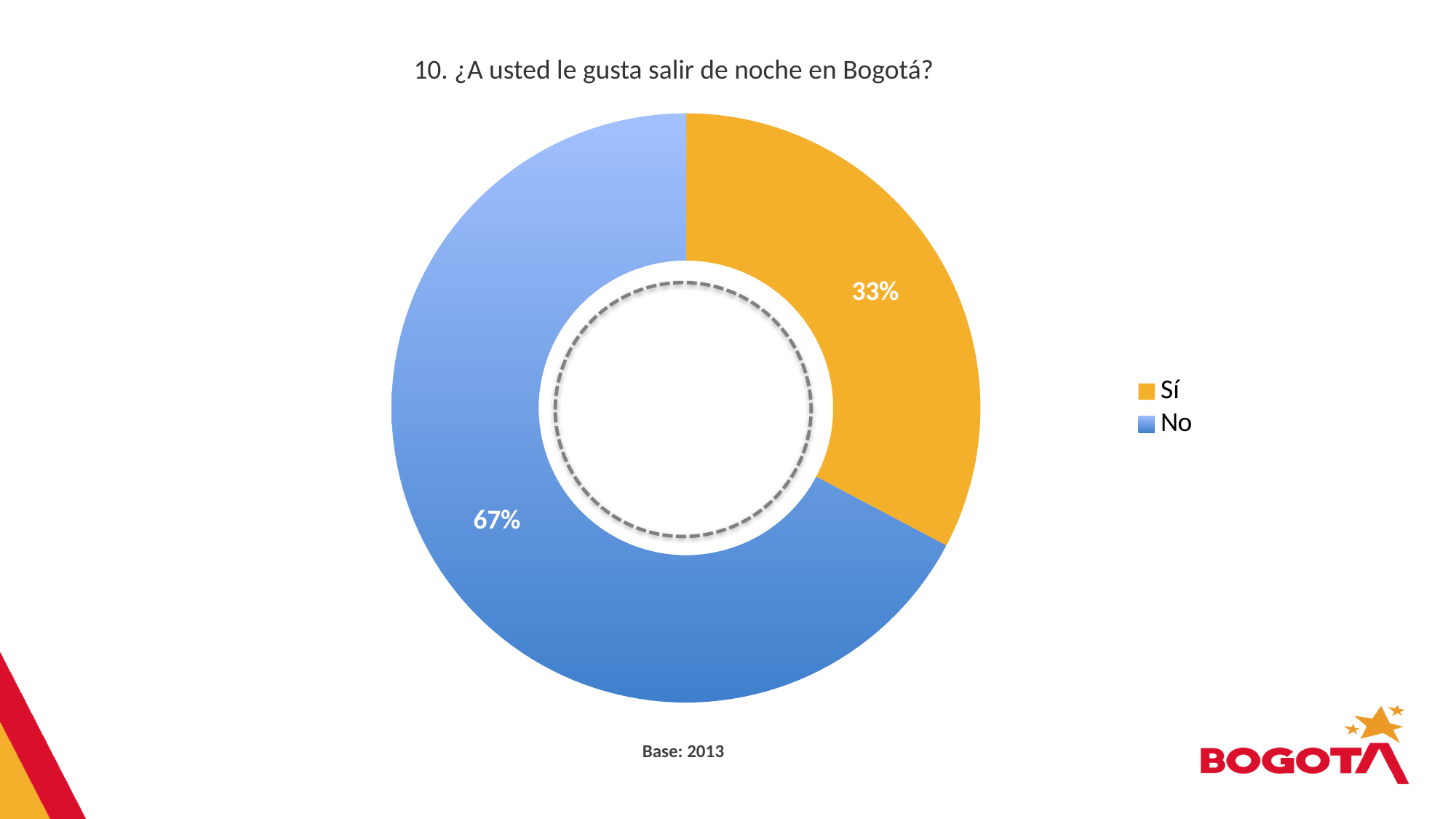
What colour represents the "Sí" response in the chart? Orange Which is larger, the share for "Sí" or the share for "No"? No What is the title of the chart? 10. ¿A usted le gusta salir de noche en Bogotá? Which response has the largest share of the chart? No What percentage of respondents answered "Sí"? 33% Which response has the smallest share of the chart? Sí What kind of chart is shown on the slide? Doughnut (pie) chart How many categories does the chart show? 2 What base (sample size) is stated below the chart? 2013 What is the difference in percentage points between the "No" and "Sí" shares? 34 What percentage of respondents answered "No"? 67% How many entries does the legend list? 2